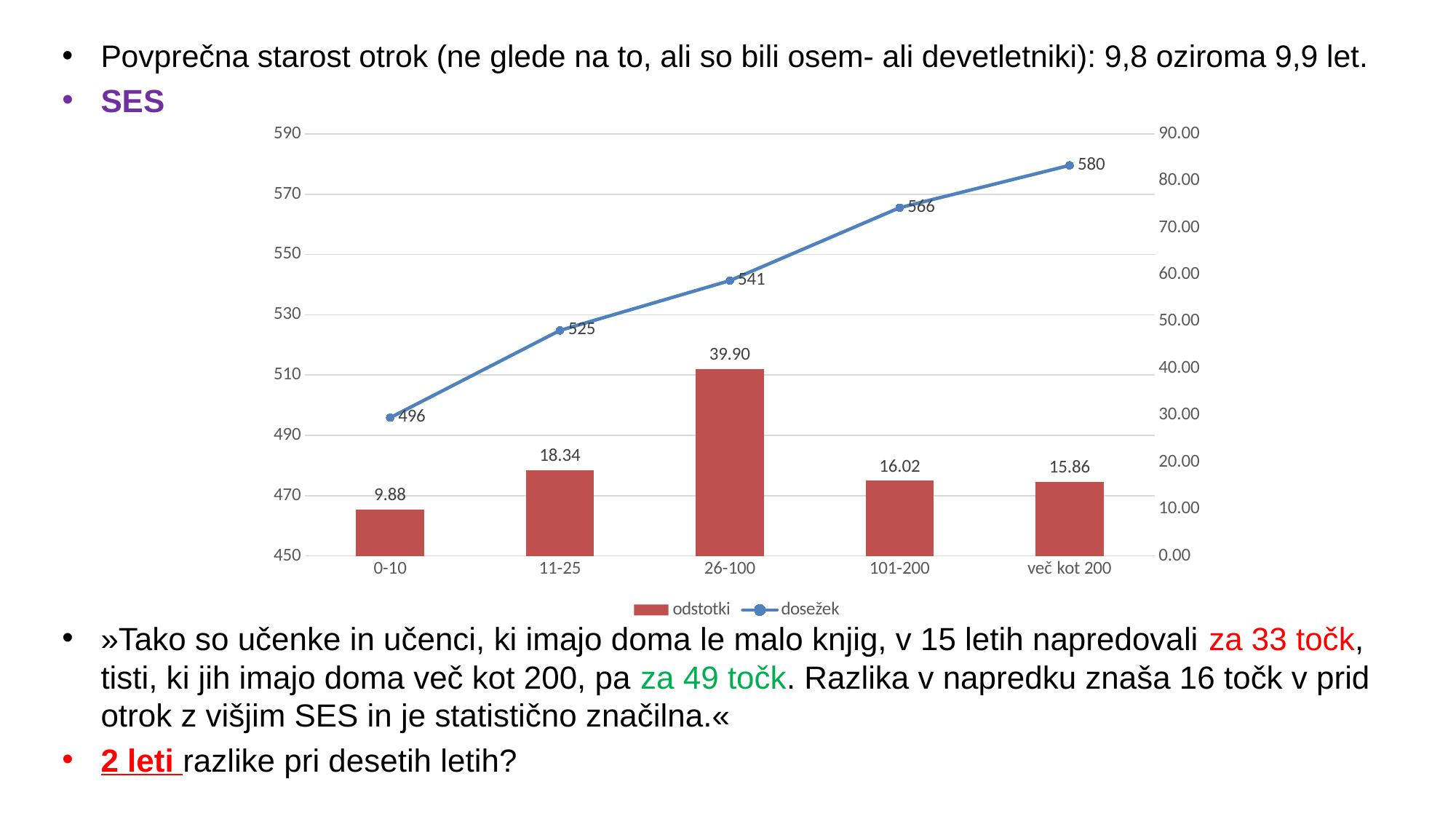
Which category has the lowest 'odstotki' value? 0-10 What is the 'dosežek' value for the '0-10' category? 496 Which series is drawn as a line in the chart? dosežek What is the difference between the 'dosežek' values for 'več kot 200' and '0-10'? 84 How many categories are shown on the x axis? 5 Which category has the highest 'odstotki' value? 26-100 Does the 'dosežek' line rise or fall from '0-10' to 'več kot 200'? rise What is the 'dosežek' value for the 'več kot 200' category? 580 What is the difference between the 'odstotki' values for '11-25' and '101-200'? 2.32 Which has a larger 'odstotki' value, '11-25' or 'več kot 200'? 11-25 How many series does the legend list? 2 What is the 'odstotki' value for the '26-100' category? 39.90